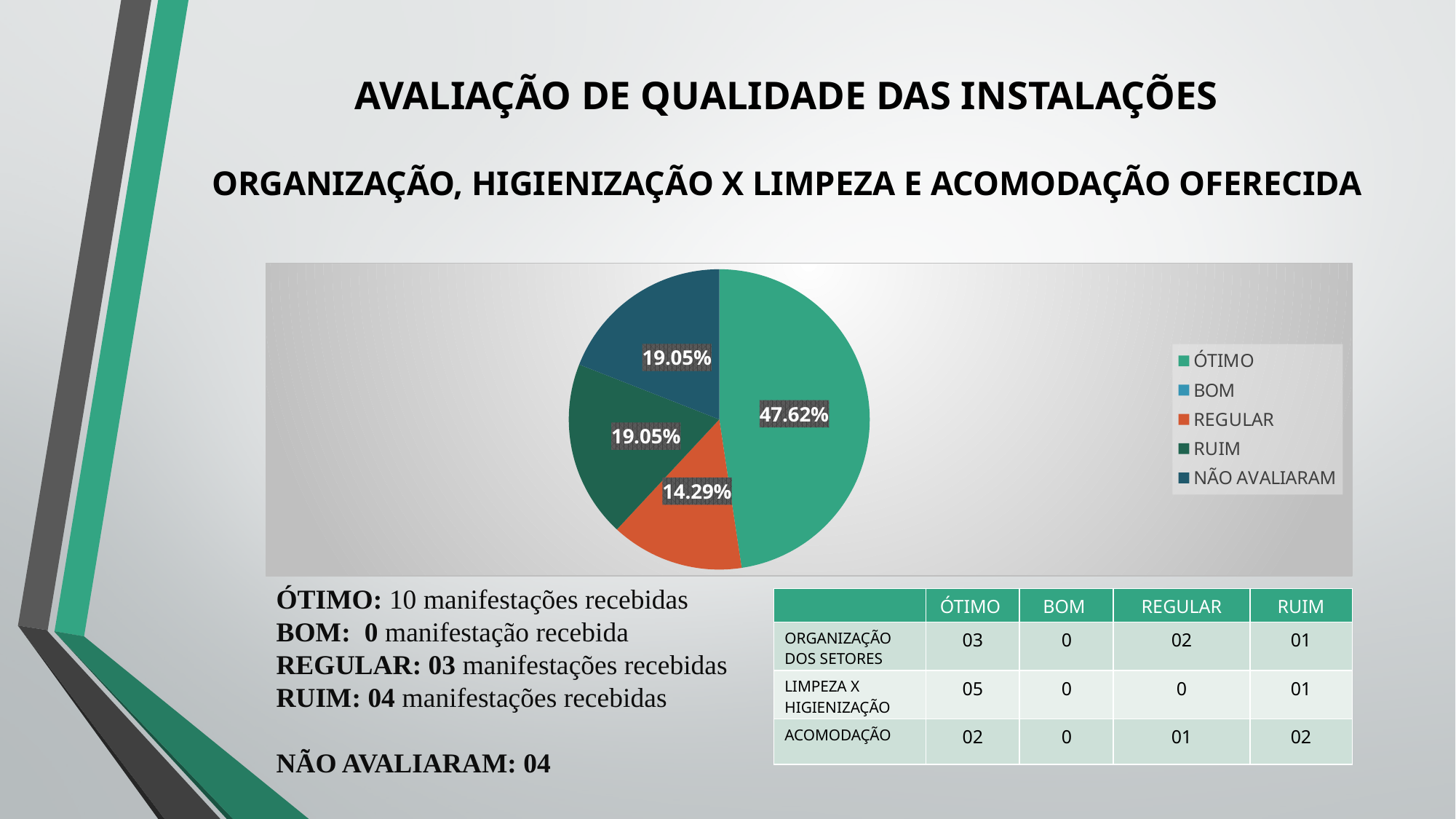
What is the difference in percentage points between the ÓTIMO slice and the REGULAR slice? 33.33 What percentage of the pie chart does REGULAR represent? 14.29% Which legend entry of the pie chart is shown in orange? REGULAR Which is larger in the pie chart, ÓTIMO or REGULAR? ÓTIMO What percentage of the pie chart does ÓTIMO represent? 47.62% How many entries does the pie chart's legend list? 5 Which category has the largest slice of the pie chart? ÓTIMO What type of chart is shown on the slide? Pie chart What is the difference in percentage points between the ÓTIMO slice and the RUIM slice? 28.57 What percentage of the pie chart does RUIM represent? 19.05% Which is larger in the pie chart, RUIM or REGULAR? RUIM What percentage of the pie chart does NÃO AVALIARAM represent? 19.05%